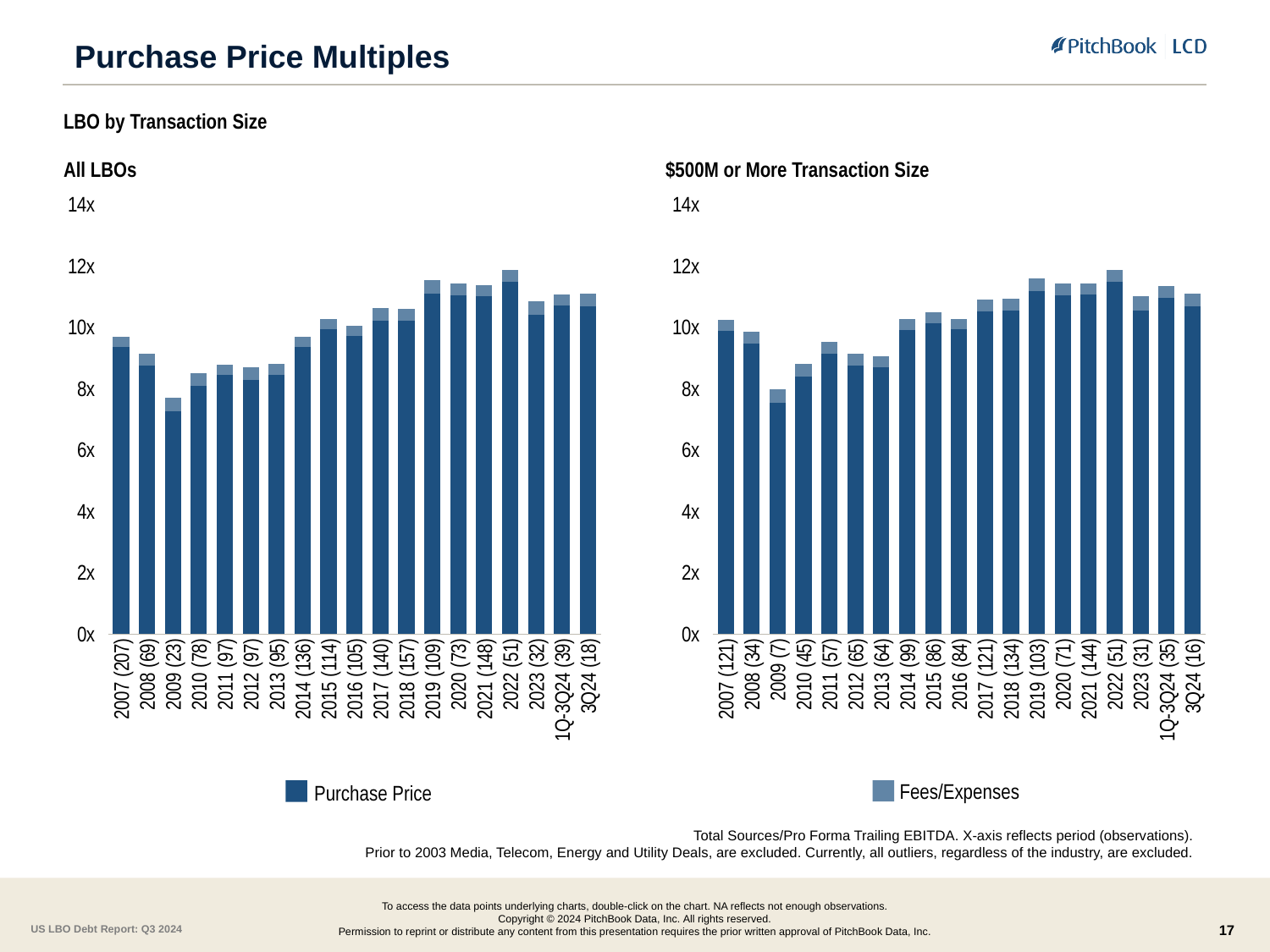
In the "All LBOs" chart, which period has the larger total multiple, 2007 (207) or 2009 (23)? 2007 (207) How many periods are shown on the x axis of the "All LBOs" chart? 19 In the "All LBOs" chart, which period has the lowest total purchase price multiple? 2009 (23) What are the two series named in the legend on this slide? Purchase Price and Fees/Expenses In the "All LBOs" chart, is the total value for 2022 (51) greater or less than 10x? greater In the "All LBOs" chart, which period has the highest total purchase price multiple? 2022 (51) In the "All LBOs" chart, is the total value for 2009 (23) greater or less than 8x? less In the "$500M or More Transaction Size" chart, which period has the lowest total purchase price multiple? 2009 (7) In the "$500M or More Transaction Size" chart, do the total multiples generally rise or fall from 2009 (7) to 2015 (86)? rise In the "$500M or More Transaction Size" chart, is the total value for 2013 (64) greater or less than 10x? less How many series does the legend list for the charts on this slide? 2 What kind of chart is the "All LBOs" chart? Stacked bar chart